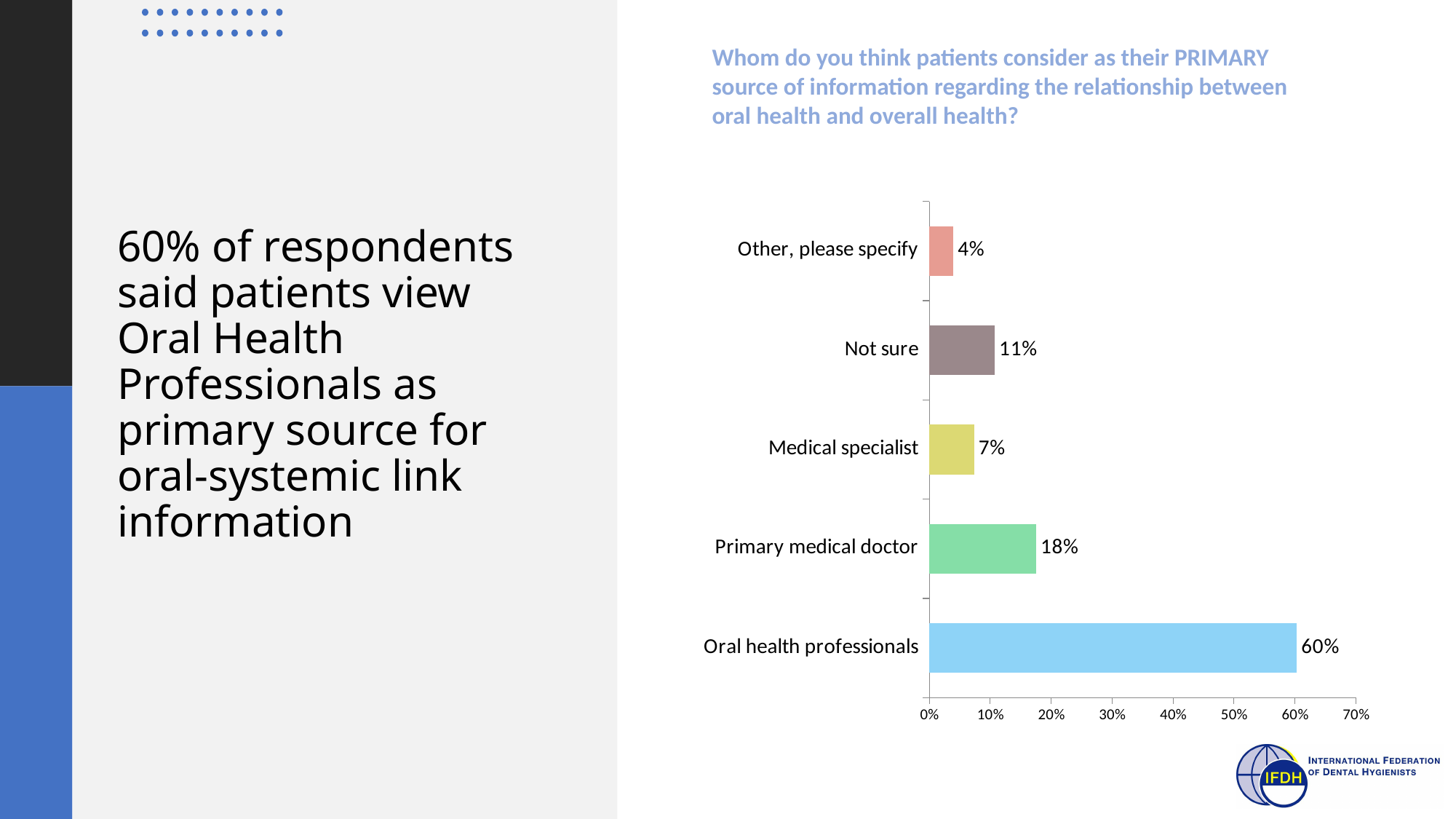
How many categories are shown in the chart? 5 What kind of chart is shown on the slide? Bar chart What is the value shown for Primary medical doctor? 18% Which category has the lowest value? Other, please specify What is the value shown for Medical specialist? 7% What is the highest value shown on the x axis of the chart? 70% Which category has the highest value? Oral health professionals What percentage of respondents said patients consider oral health professionals as their primary source of information? 60% What is the value shown for Not sure? 11% What is the difference between the values for Oral health professionals and Primary medical doctor? 42% What is the value shown for Other, please specify? 4% Which is larger, the value for Not sure or the value for Medical specialist? Not sure